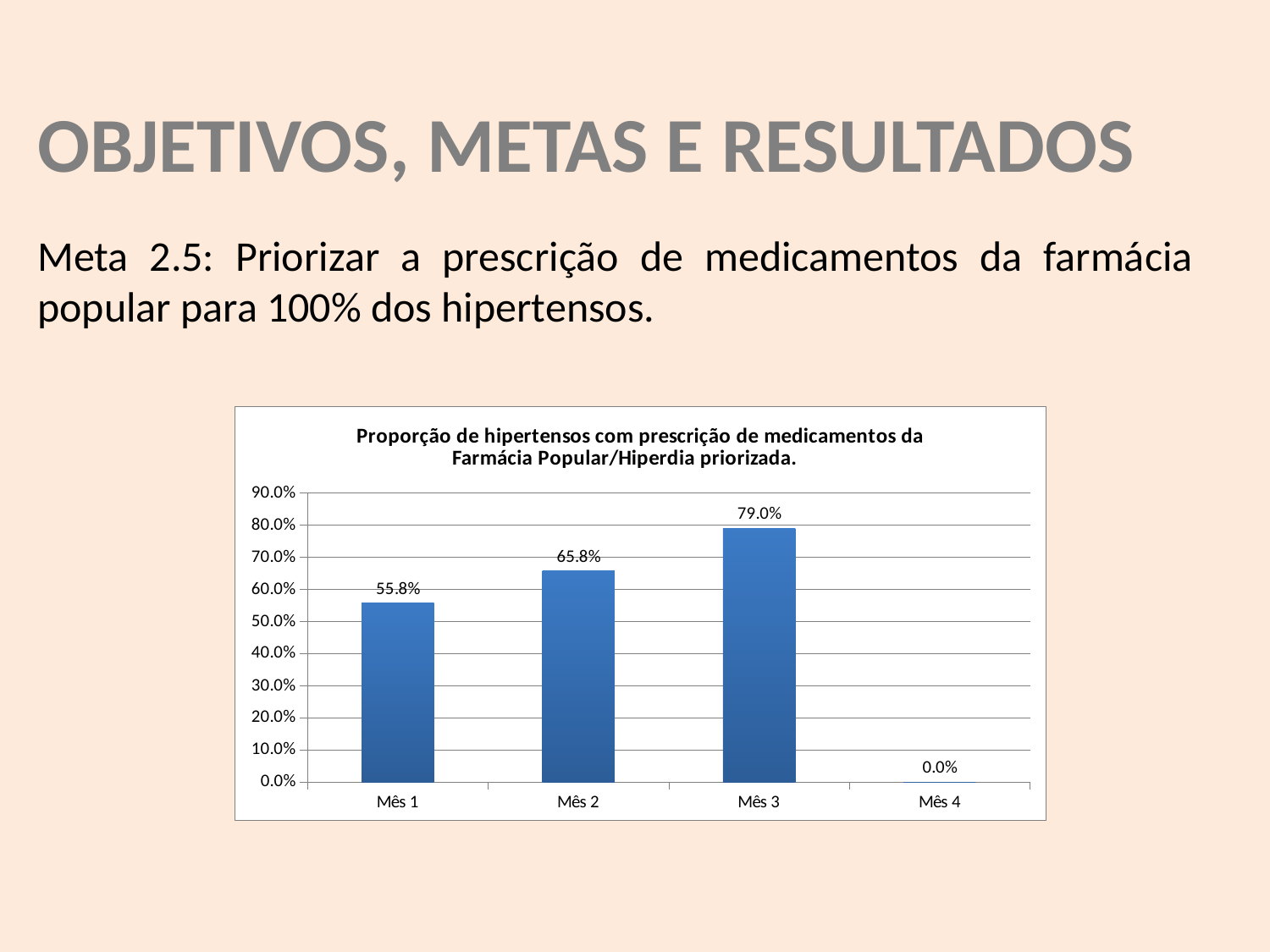
How many months are shown on the x axis? 4 Which month has the highest value? Mês 3 Which is larger, the value for Mês 2 or the value for Mês 1? Mês 2 What is the value for Mês 2? 65.8% What is the value for Mês 1? 55.8% What kind of chart is shown on the slide? Bar chart What is the difference between the values for Mês 3 and Mês 1? 23.2% What is the title of the chart? Proporção de hipertensos com prescrição de medicamentos da Farmácia Popular/Hiperdia priorizada. Which month has the lowest value? Mês 4 Is the value for Mês 2 greater or less than 60.0%? greater What is the value for Mês 4? 0.0% What is the value for Mês 3? 79.0%